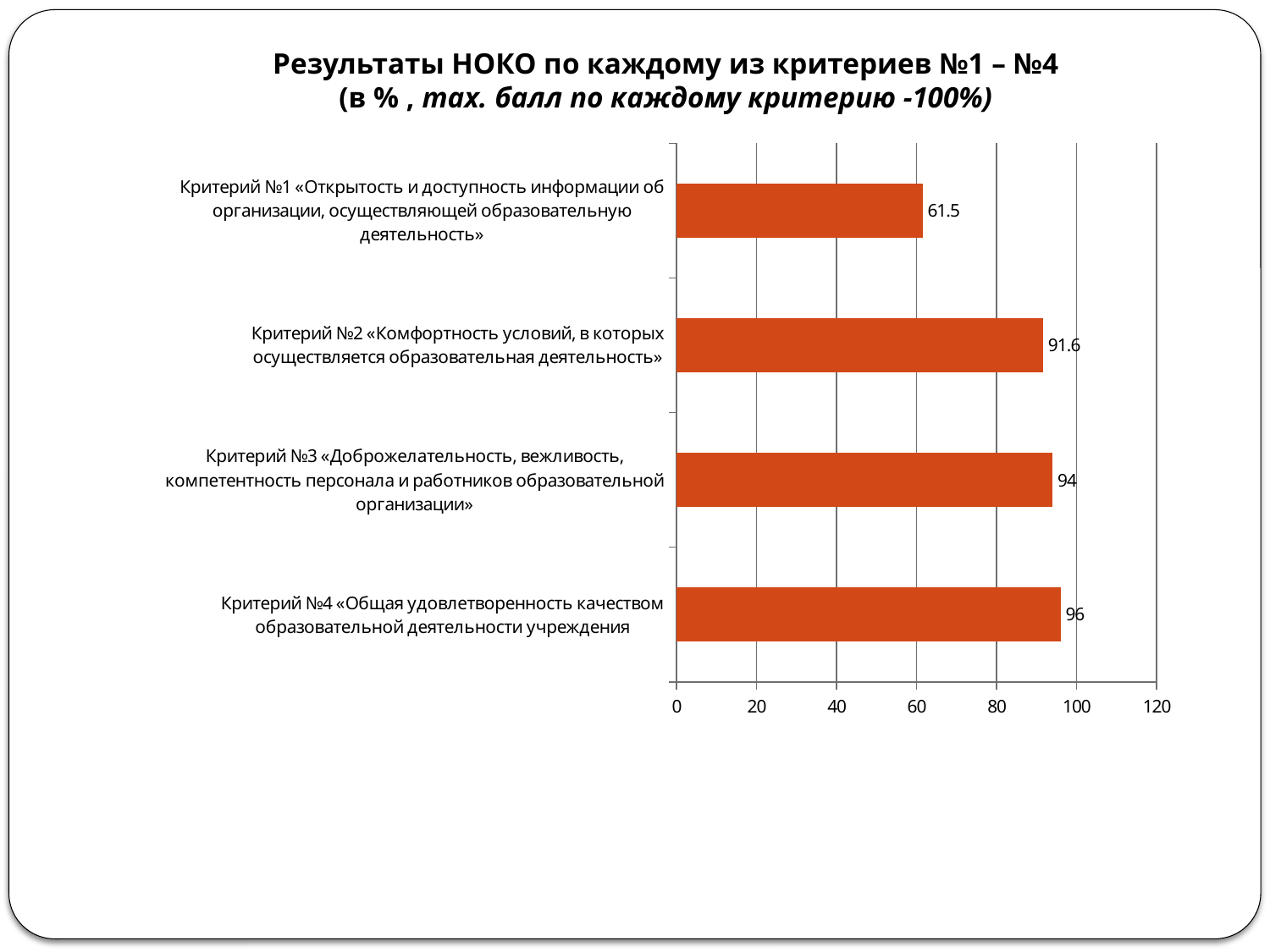
What is the difference between the values for Критерий №4 and Критерий №1? 34.5 Which criterion has the lowest value? Критерий №1 What is the value for Критерий №1 «Открытость и доступность информации об организации, осуществляющей образовательную деятельность»? 61.5 Is the value for Критерий №1 greater or less than 80? less What is the difference between the values for Критерий №3 and Критерий №2? 2.4 What is the value for Критерий №3 «Доброжелательность, вежливость, компетентность персонала и работников образовательной организации»? 94 Which criterion has the highest value? Критерий №4 Which is larger, the value for Критерий №2 or the value for Критерий №1? Критерий №2 What is the value for Критерий №4 «Общая удовлетворенность качеством образовательной деятельности учреждения»? 96 How many criteria are shown in the chart? 4 What is the value for Критерий №2 «Комфортность условий, в которых осуществляется образовательная деятельность»? 91.6 What kind of chart is shown on the slide? bar chart